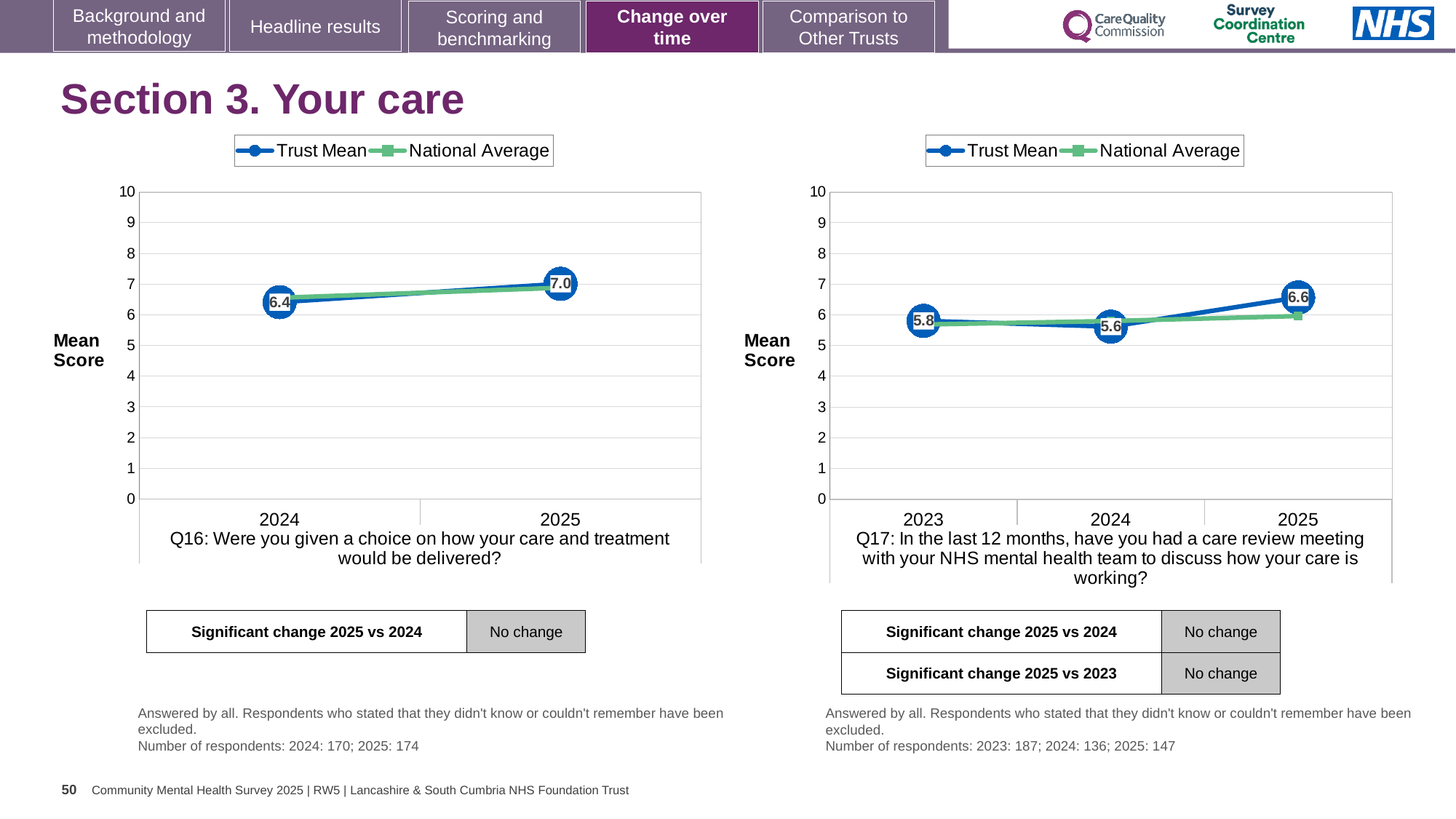
On the left chart (Q16), how many series does the legend list? 2 On the right chart (Q17), what is the difference between the Trust Mean in 2025 and in 2024? 1.0 On the right chart (Q17), what is the Trust Mean for 2023? 5.8 On the left chart (Q16), what is the Trust Mean for 2024? 6.4 On the left chart (Q16), what is the Trust Mean for 2025? 7.0 On the right chart (Q17), which year has the highest Trust Mean? 2025 On the left chart (Q16), by how much did the Trust Mean change from 2024 to 2025? 0.6 On the left chart (Q16), does the Trust Mean rise or fall from 2024 to 2025? rise What type of chart is used on the right (Q17)? line chart On the right chart (Q17), what is the Trust Mean for 2025? 6.6 On the right chart (Q17), how many years are shown on the x axis? 3 On the right chart (Q17), which year has the lowest Trust Mean? 2024